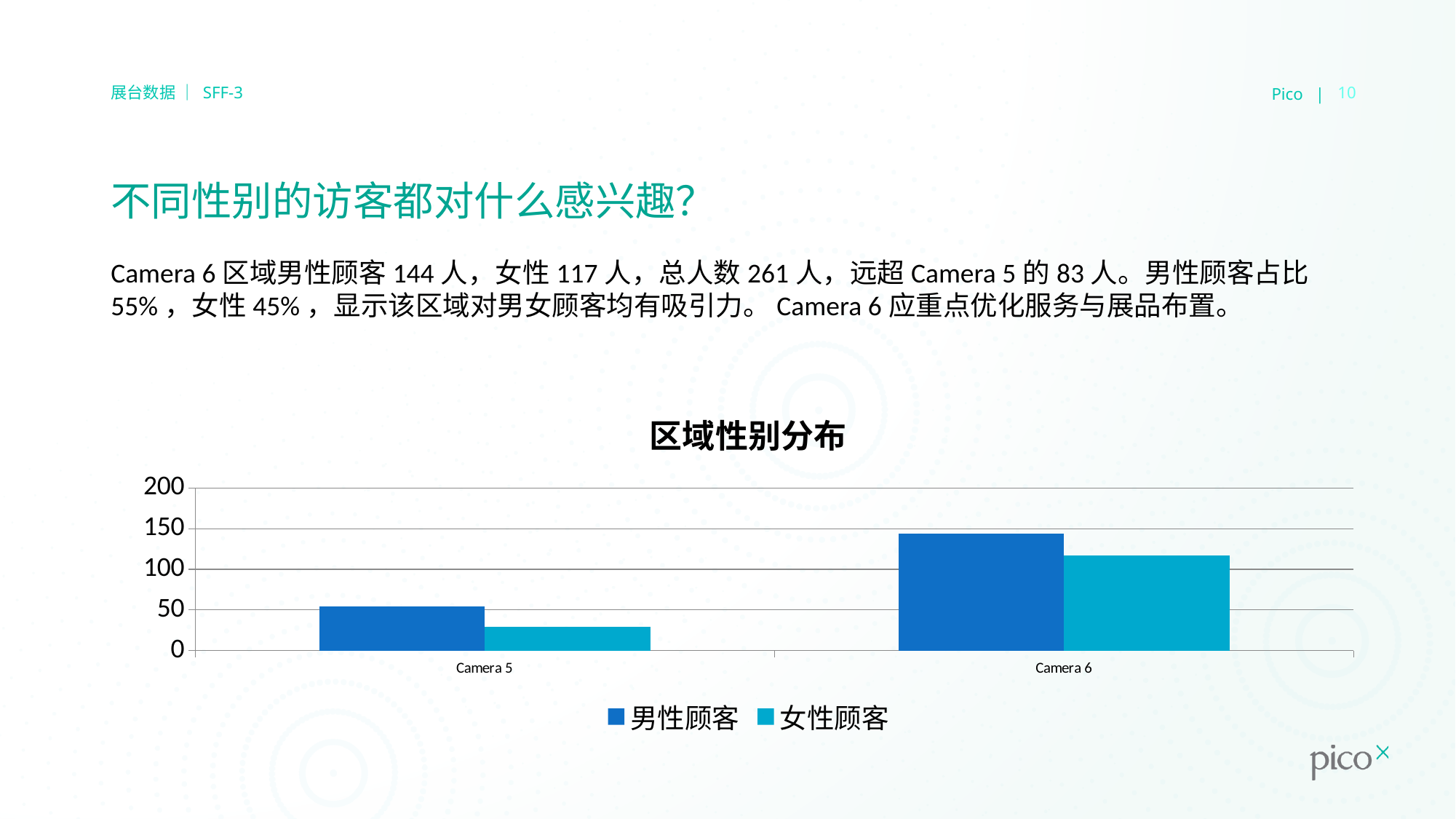
How many categories are shown on the x axis of the chart? 2 For Camera 6, which is larger, 男性顾客 or 女性顾客? 男性顾客 Is the 女性顾客 value for Camera 5 greater or less than 50? less How many series does the chart legend list? 2 Is the 男性顾客 value for Camera 6 greater or less than 100? greater Which category has the lowest 女性顾客 value? Camera 5 What is the 男性顾客 value for Camera 6? 144 What is the difference between the 男性顾客 and 女性顾客 values for Camera 6? 27 Which category has the highest 男性顾客 value? Camera 6 What type of chart is shown on the slide? bar chart Is the 男性顾客 value for Camera 5 greater or less than 100? less What is the title of the chart? 区域性别分布